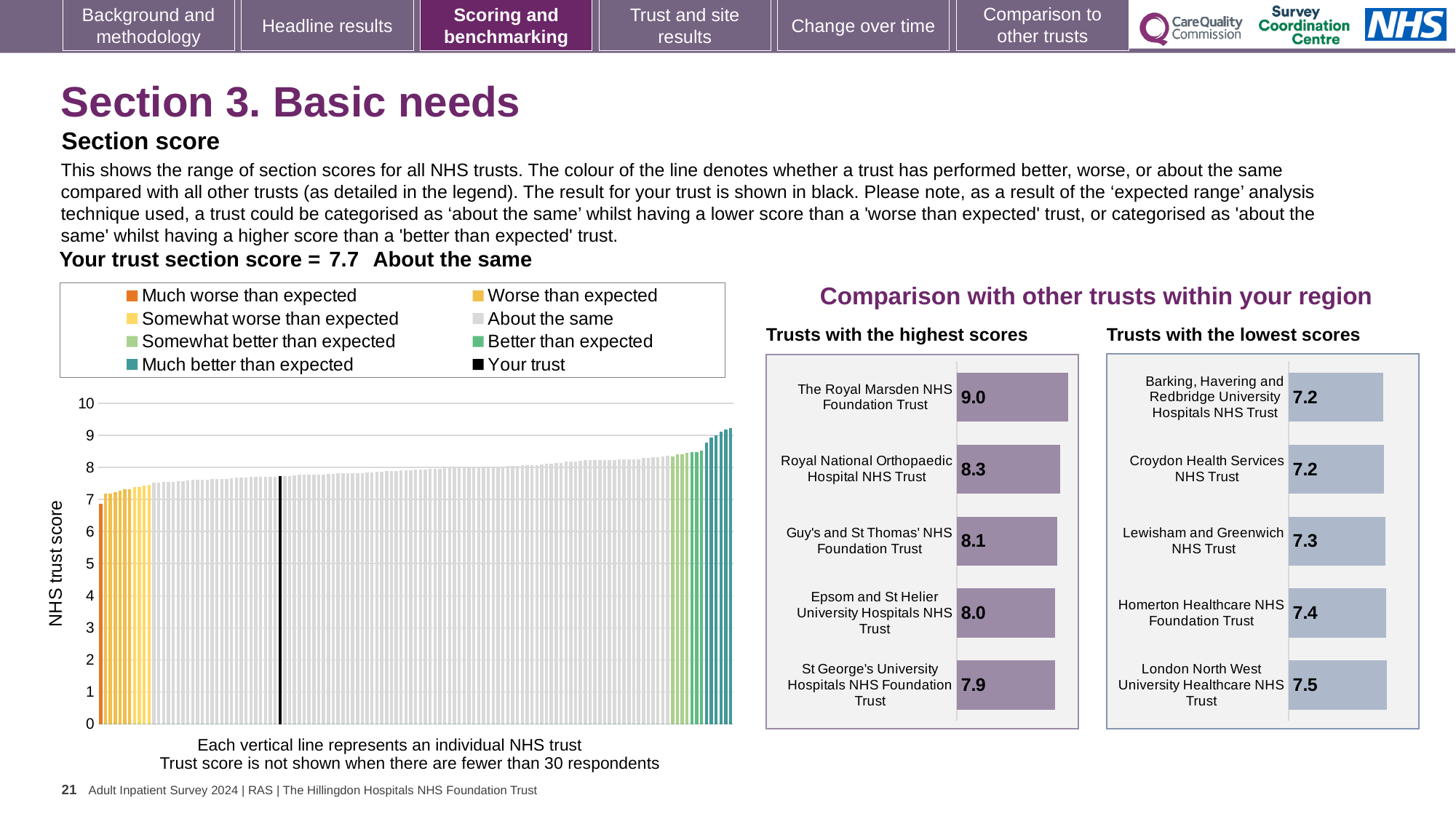
In the 'Trusts with the lowest scores' chart, what is the difference between the scores of London North West University Healthcare NHS Trust and Croydon Health Services NHS Trust? 0.3 In the 'Trusts with the highest scores' chart, what is the difference between the scores of The Royal Marsden NHS Foundation Trust and St George's University Hospitals NHS Foundation Trust? 1.1 In the 'Trusts with the lowest scores' chart, which trust has the highest score shown? London North West University Healthcare NHS Trust In the 'Trusts with the highest scores' chart, what is the score for Guy's and St Thomas' NHS Foundation Trust? 8.1 In the 'Trusts with the lowest scores' chart, which has the higher score: Lewisham and Greenwich NHS Trust or Homerton Healthcare NHS Foundation Trust? Homerton Healthcare NHS Foundation Trust In the 'Trusts with the highest scores' chart, what is the score for The Royal Marsden NHS Foundation Trust? 9.0 In the large chart on the left showing all NHS trusts, is the value for the black 'Your trust' bar greater or less than 8? less In the large chart on the left showing all NHS trusts, do the bar values rise or fall from left to right? rise In the 'Trusts with the lowest scores' chart, what is the score for Homerton Healthcare NHS Foundation Trust? 7.4 In the 'Trusts with the highest scores' chart, which trust has the lowest score shown? St George's University Hospitals NHS Foundation Trust How many entries does the legend of the large chart on the left list? 8 How many trusts are listed in the 'Trusts with the highest scores' chart? 5